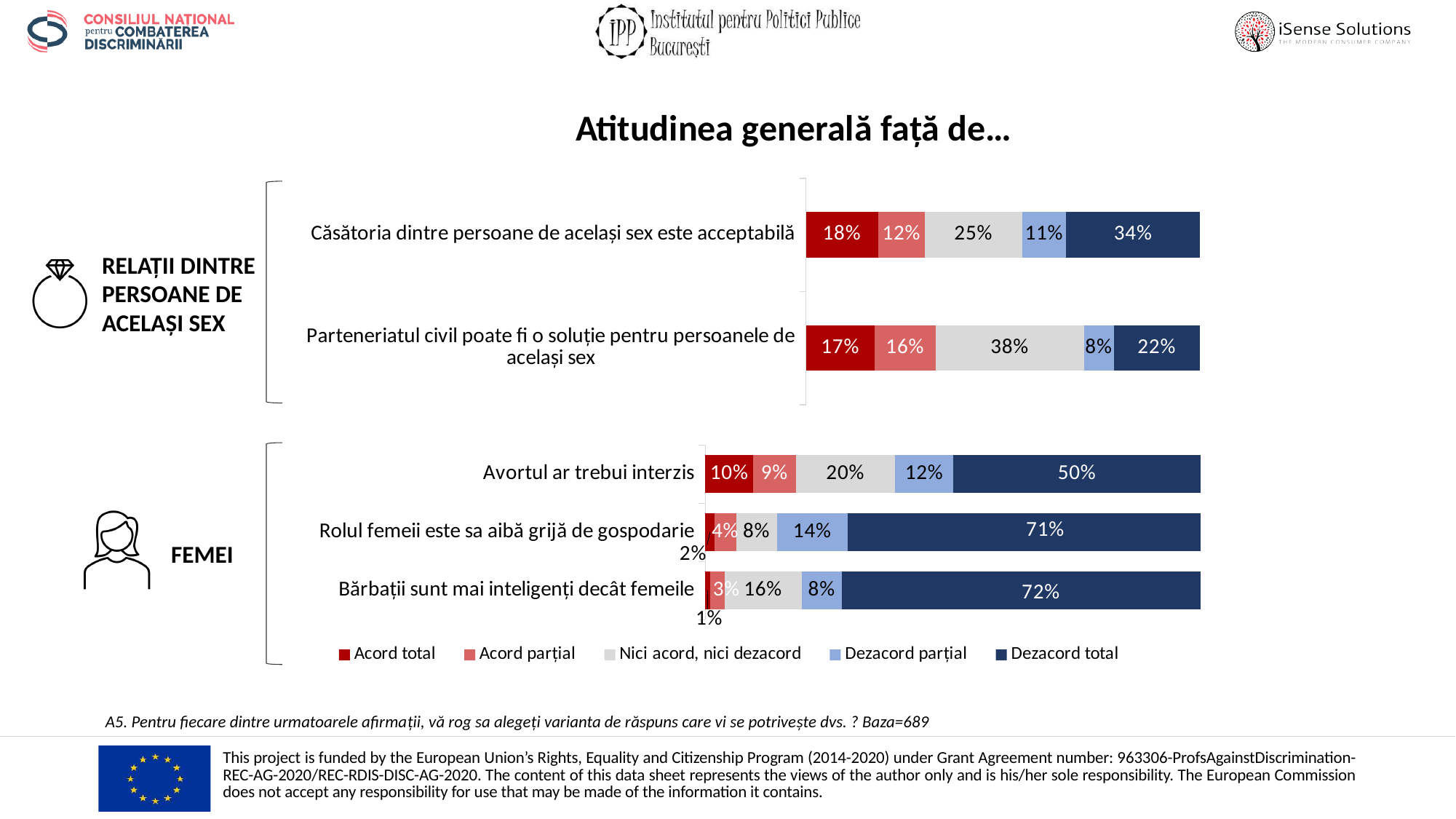
In the top chart (Relații dintre persoane de același sex), what is the 'Dezacord total' value for 'Căsătoria dintre persoane de același sex este acceptabilă'? 34% In the bottom chart (Femei), which statement has the highest 'Dezacord total' value? Bărbații sunt mai inteligenți decât femeile In the bottom chart (Femei), what is the 'Acord total' value for 'Avortul ar trebui interzis'? 10% How many series does the legend list? 5 What is the title of the slide? Atitudinea generală față de... In the bottom chart (Femei), is the 'Dezacord total' value larger for 'Avortul ar trebui interzis' or for 'Rolul femeii este sa aibă grijă de gospodarie'? Rolul femeii este sa aibă grijă de gospodarie What kind of chart is used on this slide? Stacked bar chart In the bottom chart (Femei), what is the 'Dezacord total' value for 'Bărbații sunt mai inteligenți decât femeile'? 72% In the top chart (Relații dintre persoane de același sex), what is the difference between the 'Dezacord total' values for the two statements? 12% In the bottom chart (Femei), which statement has the lowest 'Acord total' value? Bărbații sunt mai inteligenți decât femeile In the top chart (Relații dintre persoane de același sex), what is the 'Nici acord, nici dezacord' value for 'Parteneriatul civil poate fi o soluție pentru persoanele de același sex'? 38% How many statements are shown in the bottom chart (Femei)? 3